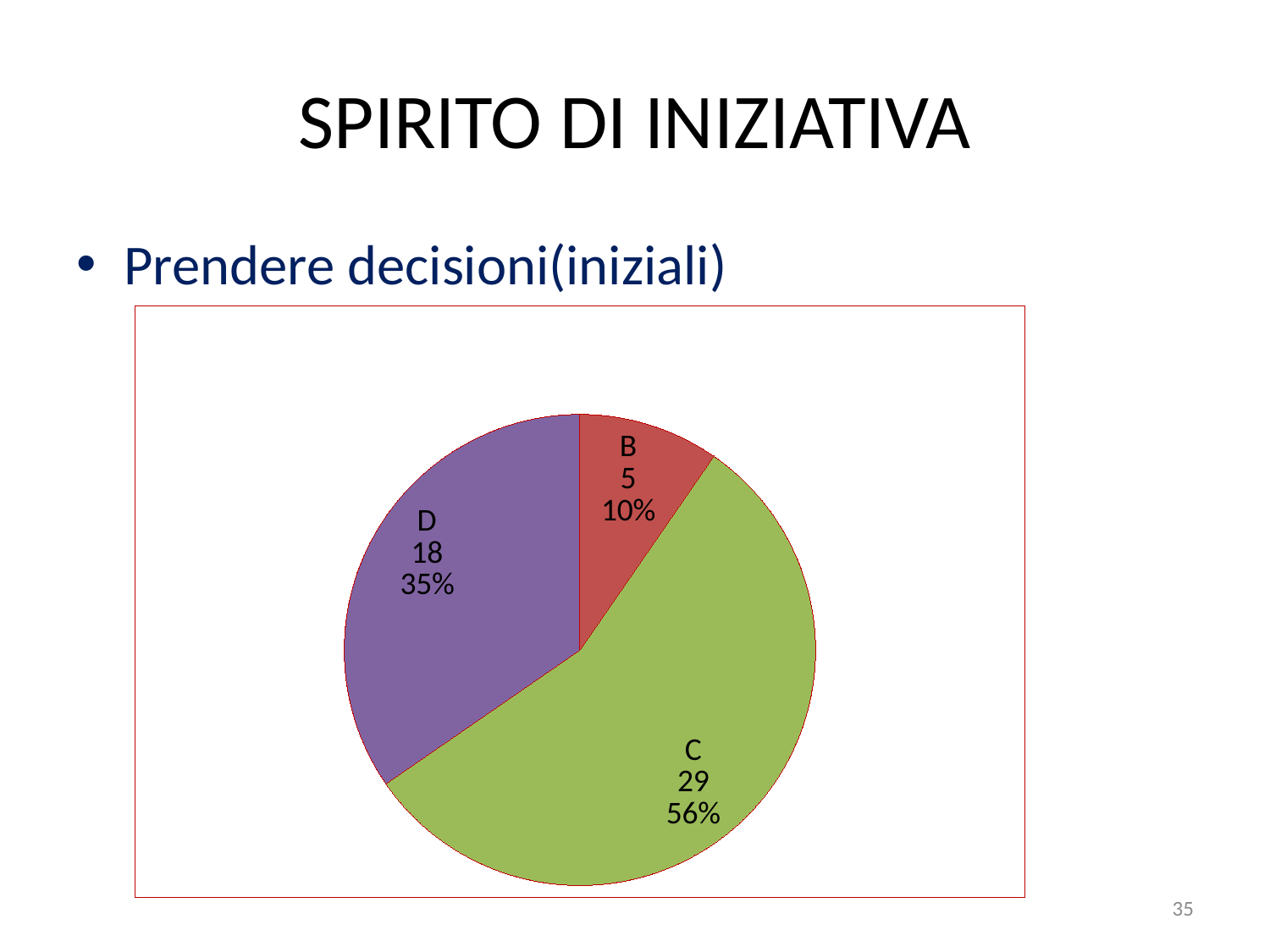
What is the value for slice D? 18 Which is larger, the value for D or the value for B? D How many slices does the pie chart have? 3 What is the difference between the values of slices C and D? 11 Which slice is the smallest? B What percentage share does slice C have? 56% What percentage share does slice B have? 10% Which slice is the largest? C What is the value for slice C? 29 What kind of chart is shown on the slide? pie chart What is the value for slice B? 5 What percentage share does slice D have? 35%